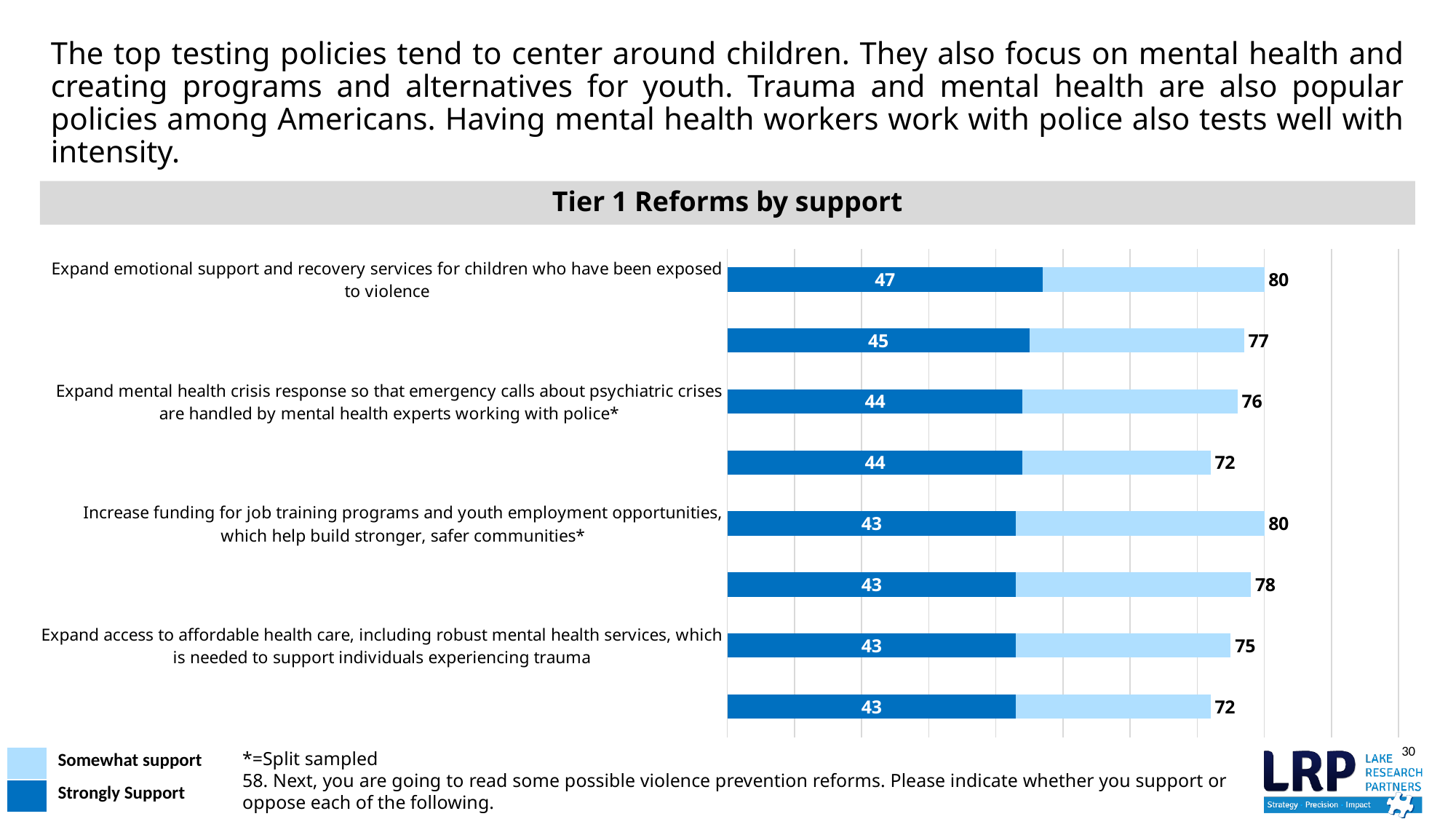
What is the difference in Strongly Support between "Expand emotional support and recovery services for children who have been exposed to violence" and "Expand mental health crisis response"? 3 How many series does the legend list? 2 What is the total support value for "Expand access to affordable health care, including robust mental health services, which is needed to support individuals experiencing trauma"? 75 What kind of chart is shown on the slide? Stacked bar chart How many bars are plotted in the chart? 8 What is the total support value for "Increase funding for job training programs and youth employment opportunities, which help build stronger, safer communities"? 80 Which has a higher total support value: "Increase funding for job training programs and youth employment opportunities" or "Expand access to affordable health care"? Increase funding for job training programs and youth employment opportunities What is the total support value shown at the end of the bar for "Expand emotional support and recovery services for children who have been exposed to violence"? 80 What is the Strongly Support value for "Expand mental health crisis response so that emergency calls about psychiatric crises are handled by mental health experts working with police"? 44 What is the Strongly Support value for "Expand emotional support and recovery services for children who have been exposed to violence"? 47 Which reform has the highest Strongly Support value? Expand emotional support and recovery services for children who have been exposed to violence What is the title of the chart? Tier 1 Reforms by support